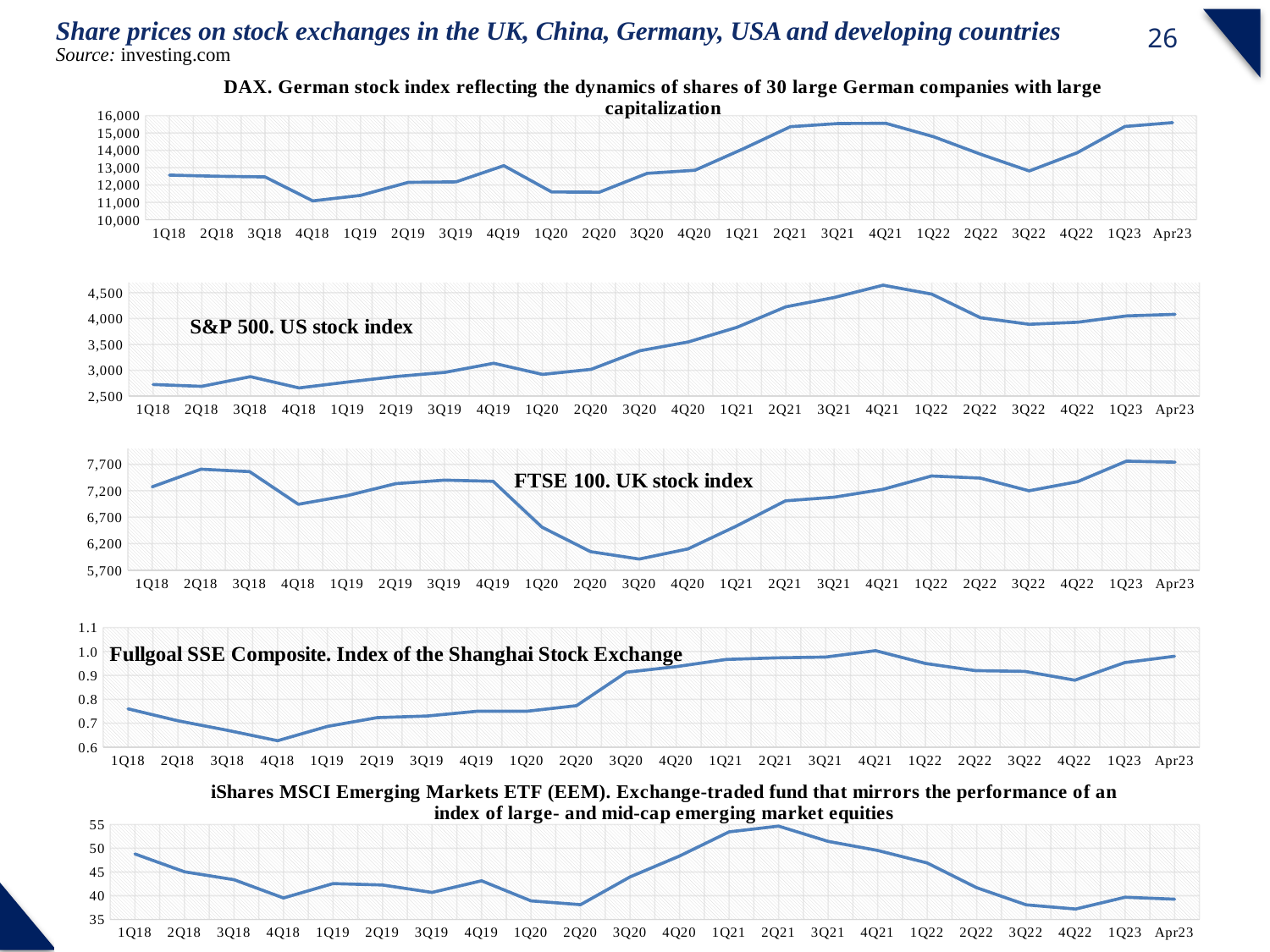
In the S&P 500 chart, which is larger: the value for 4Q21 or the value for 1Q18? 4Q21 In the FTSE 100 chart, does the index rise or fall between 4Q19 and 3Q20? Fall In the Fullgoal SSE Composite chart, is the value for 4Q18 greater or less than 0.7? less In the S&P 500 chart, at which time point is the index highest? 4Q21 In the DAX chart, at which time point is the index lowest? 4Q18 In the iShares MSCI Emerging Markets ETF chart, at which time point is the value highest? 2Q21 What kind of chart is the DAX chart at the top of the slide? Line chart In the iShares MSCI Emerging Markets ETF chart, is the value for 4Q22 greater or less than 40? less In the FTSE 100 chart, at which time point is the index lowest? 3Q20 In the DAX chart, is the value for 2Q21 greater or less than 15,000? greater What source is cited for the data on the slide? investing.com How many time points are plotted along the x axis of the S&P 500 chart? 22